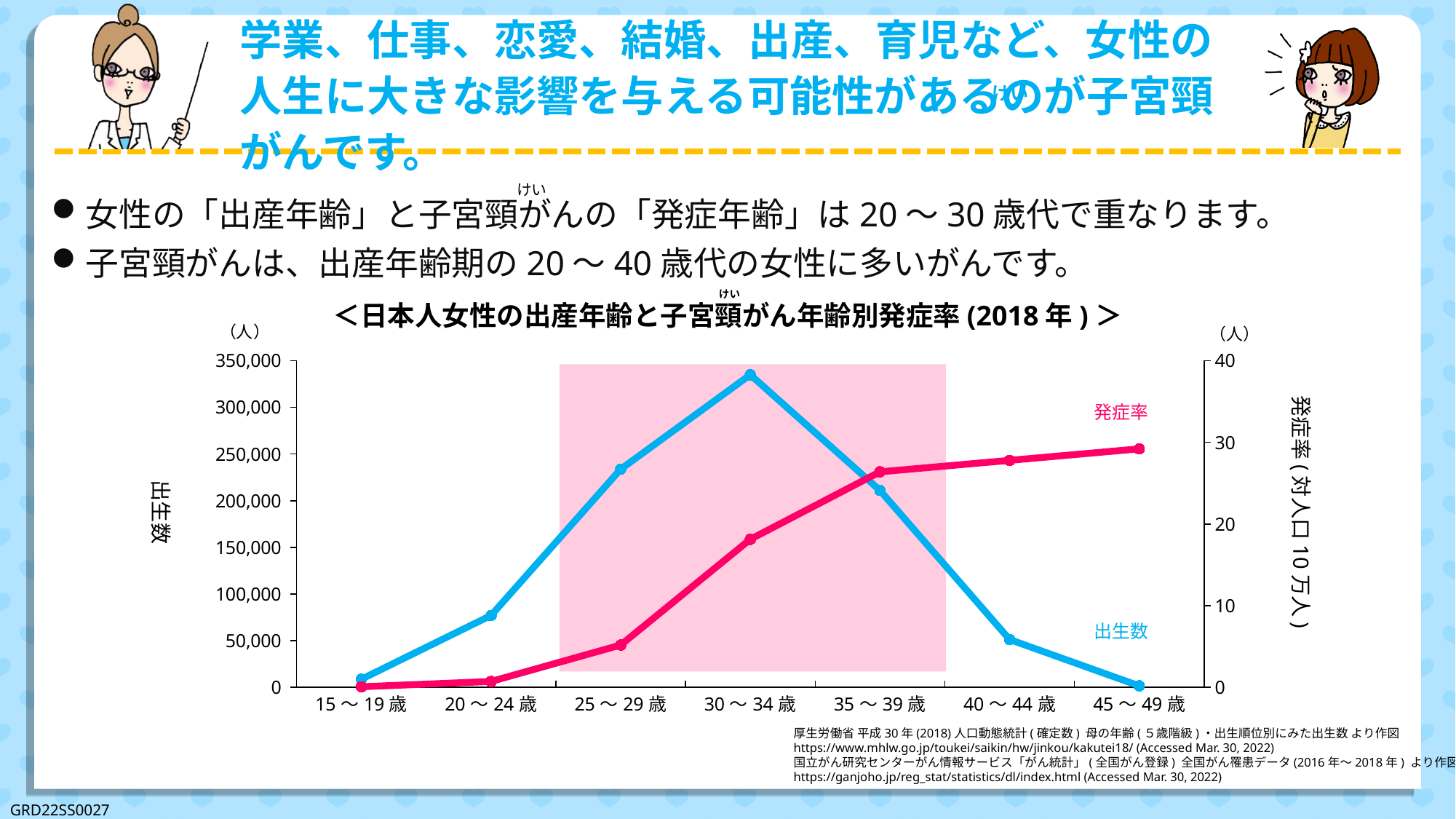
How many data series are plotted in the chart? 2 What colour is the line for 発症率? pink Which is larger, the 出生数 for 20～24歳 or for 40～44歳? 20～24歳 Is the value of 発症率 for 35～39歳 greater or less than 20? greater What kind of chart is shown on the slide? line chart How many age-group categories are plotted along the x axis? 7 Which age group has the highest value for 発症率? 45～49歳 Is the value of 出生数 for 30～34歳 greater or less than 300,000? greater Is the value of 出生数 for 40～44歳 greater or less than 100,000? less Which age group has the highest value for 出生数? 30～34歳 Which age group has the lowest value for 発症率? 15～19歳 Does the 発症率 series rise or fall as age increases along the x axis? rise